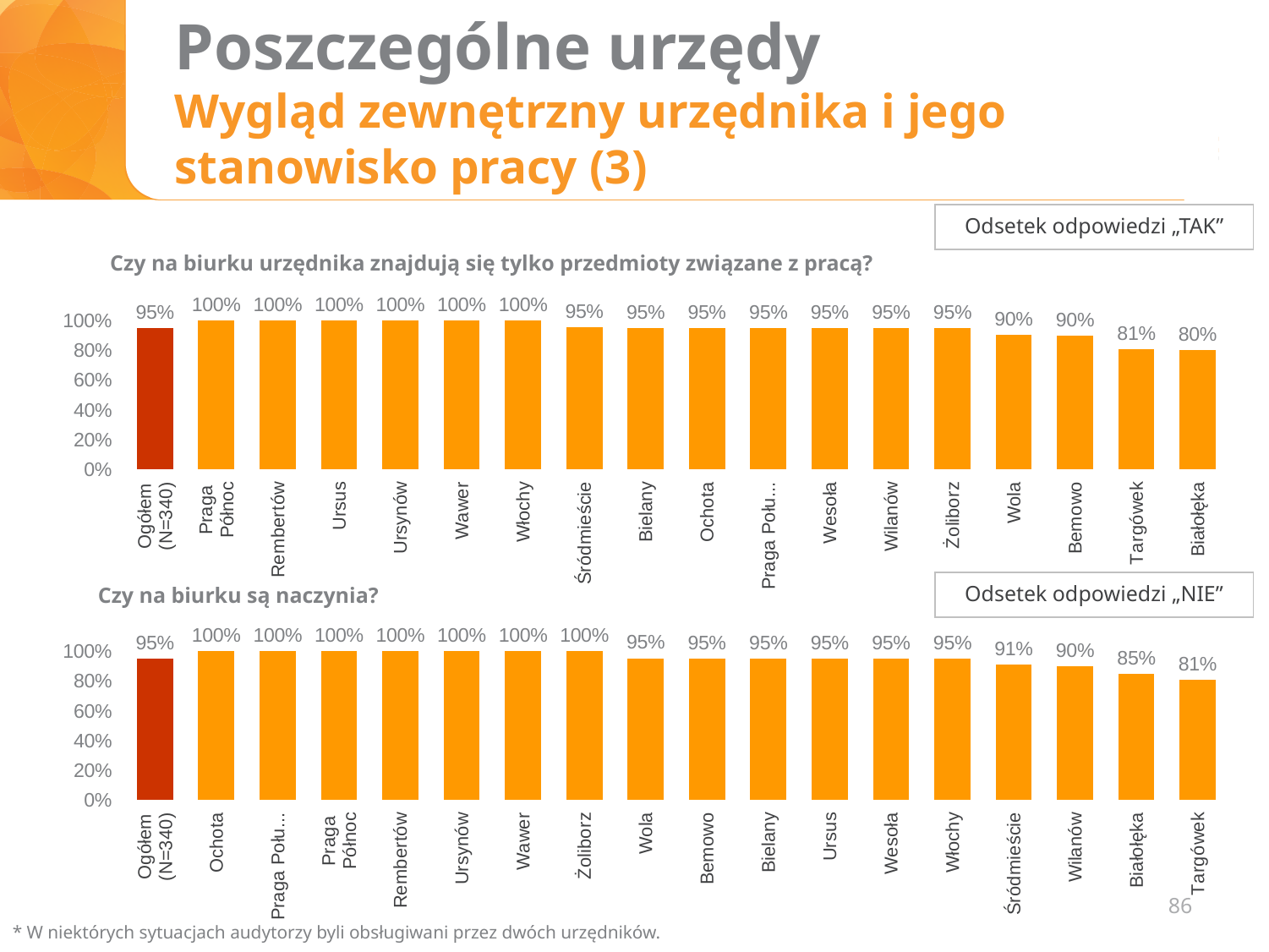
In the bottom chart ("Czy na biurku są naczynia?"), which is larger, the value for Wilanów or the value for Targówek? Wilanów In the bottom chart ("Czy na biurku są naczynia?"), what is the difference between the values for Ochota and Białołęka? 15% In the bottom chart ("Czy na biurku są naczynia?"), what is the value for Białołęka? 85% In the top chart ("Czy na biurku urzędnika znajdują się tylko przedmioty związane z pracą?"), which category has the lowest value? Białołęka In the bottom chart ("Czy na biurku są naczynia?"), what is the value for Śródmieście? 91% In the top chart ("Czy na biurku urzędnika znajdują się tylko przedmioty związane z pracą?"), how many categories are shown? 18 In the bottom chart ("Czy na biurku są naczynia?"), which category has the lowest value? Targówek In the top chart ("Czy na biurku urzędnika znajdują się tylko przedmioty związane z pracą?"), what is the value for Ogółem (N=340)? 95% In the top chart ("Czy na biurku urzędnika znajdują się tylko przedmioty związane z pracą?"), what is the difference between the values for Wola and Targówek? 9% According to the label box next to the bottom chart, what do the bottom chart's values represent? Odsetek odpowiedzi „NIE” What kind of chart is the bottom chart ("Czy na biurku są naczynia?")? Bar chart In the top chart ("Czy na biurku urzędnika znajdują się tylko przedmioty związane z pracą?"), what is the value for Wola? 90%